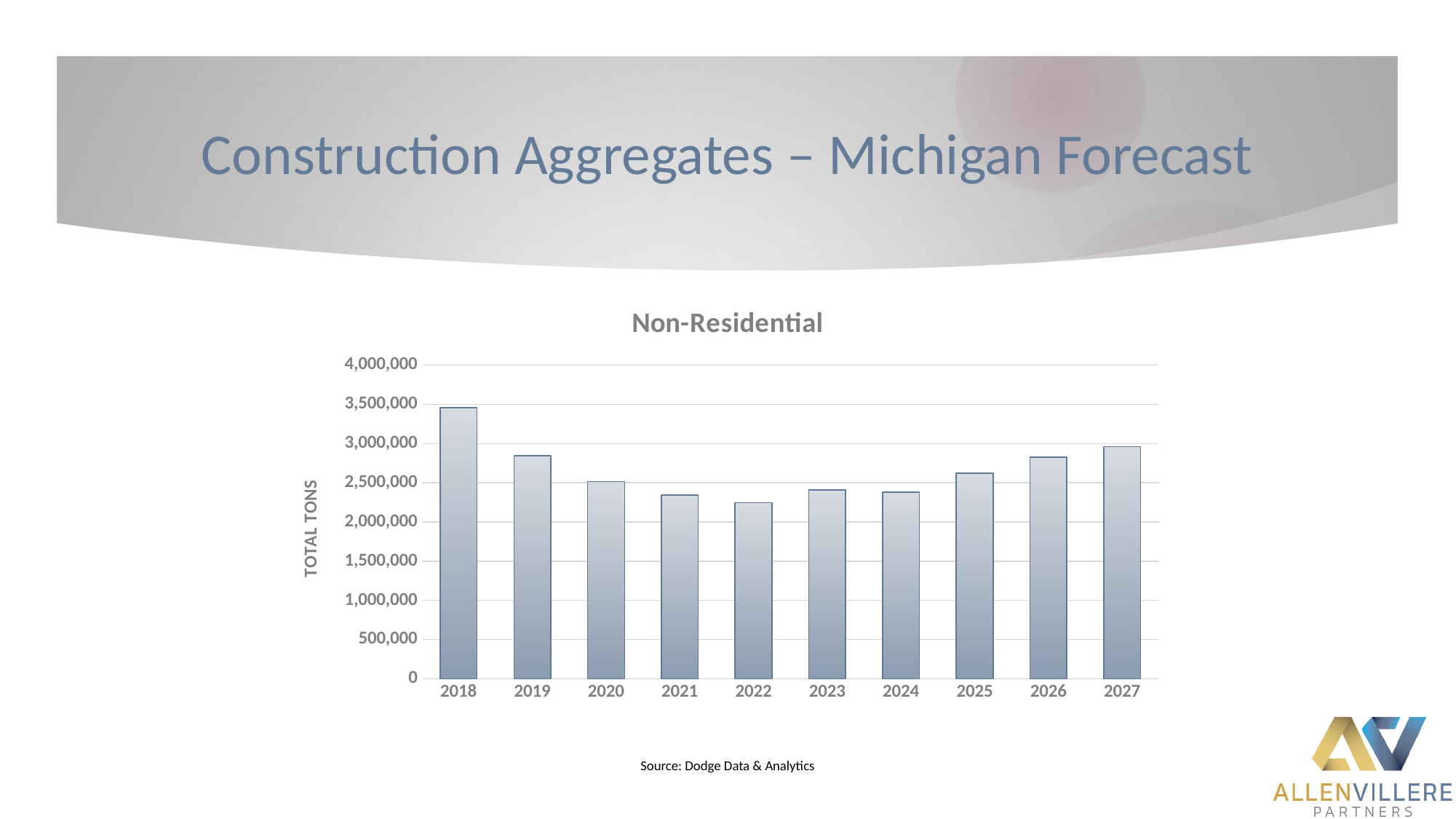
Is the value for 2018 greater or less than 3,000,000? greater Do the values rise or fall from 2022 to 2027? rise How many years are shown on the x axis of the chart? 10 Is the value for 2021 greater or less than 2,500,000? less What is the label on the vertical axis of the chart? TOTAL TONS What type of chart is shown on the slide? Bar chart Is the value for 2025 greater or less than 2,500,000? greater Which year has the lowest total tons? 2022 Which year has the highest total tons? 2018 What is the title of the chart? Non-Residential Which is larger, the value for 2026 or the value for 2027? 2027